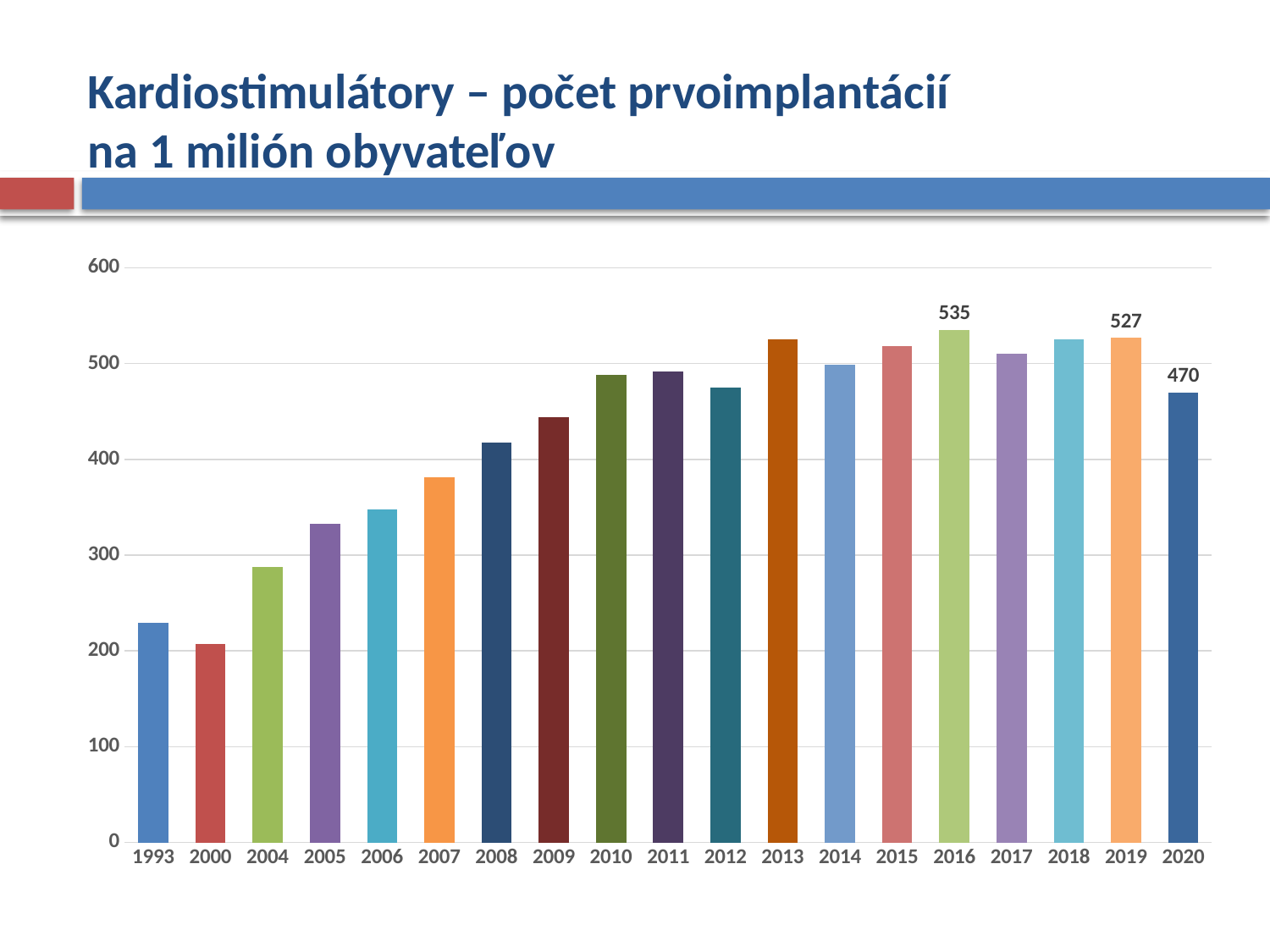
Which is larger, the value for 2019 or the value for 2020? 2019 What is the value for 2019? 527 Which year has the lowest value? 2000 Is the value for 1993 greater or less than 300? less What is the value for 2020? 470 Is the value for 2013 greater or less than 500? greater What is the difference between the values for 2016 and 2020? 65 Which year has the highest value? 2016 How many years are shown on the x axis? 19 What is the difference between the values for 2019 and 2020? 57 What kind of chart is shown on the slide? bar chart What is the value for 2016? 535